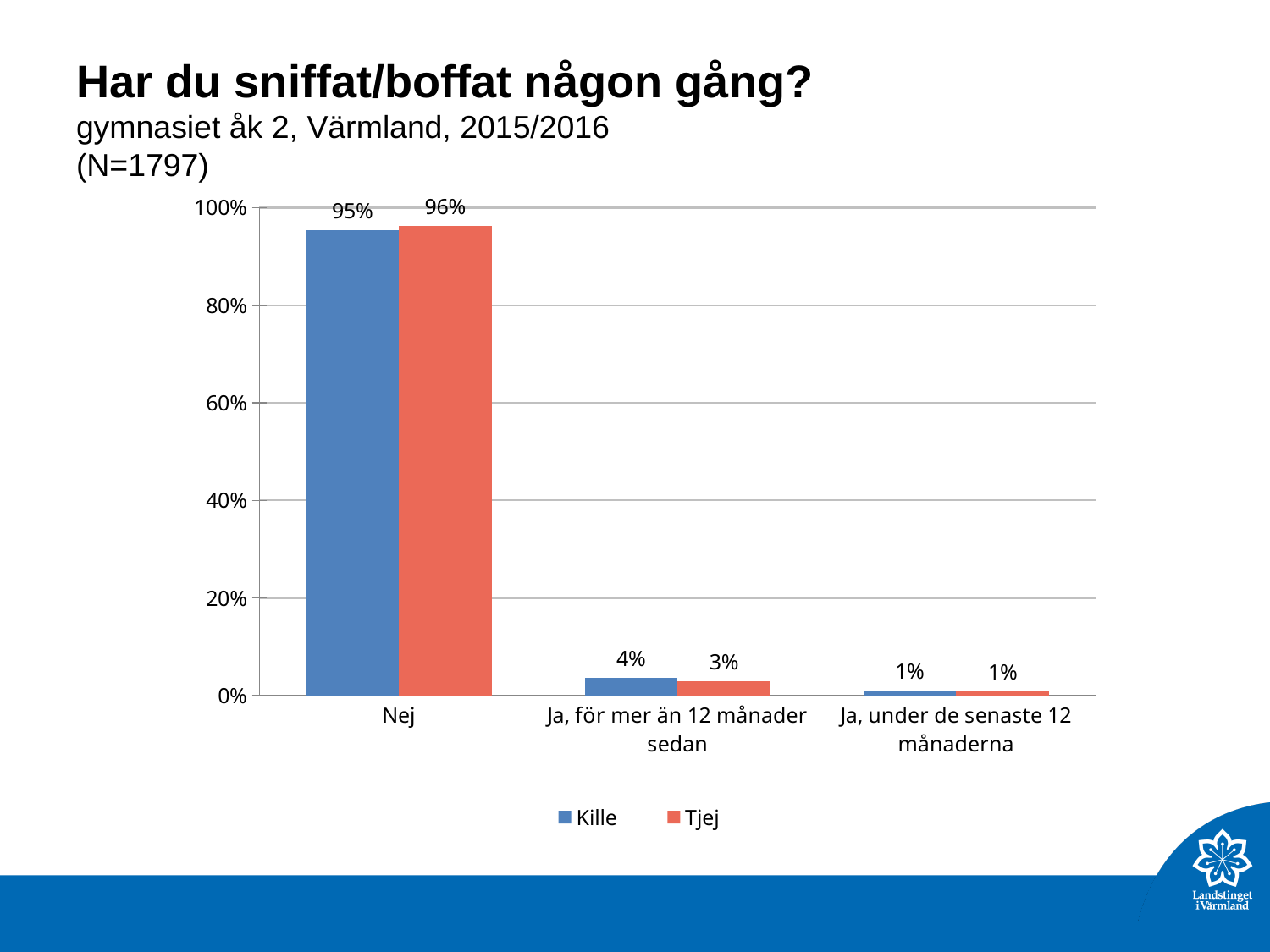
What is the difference between the Tjej and Kille values in the Nej category? 1% How many series does the legend list? 2 In the category 'Ja, för mer än 12 månader sedan', which series has the larger value, Kille or Tjej? Kille What is the value for Kille in the category 'Ja, under de senaste 12 månaderna'? 1% What is the value for Kille in the category 'Ja, för mer än 12 månader sedan'? 4% How many categories are shown on the x axis? 3 What is the value for Kille in the Nej category? 95% Which category has the highest value for Tjej? Nej What kind of chart is shown on the slide? Bar chart What is the value for Tjej in the Nej category? 96% What is the value for Tjej in the category 'Ja, för mer än 12 månader sedan'? 3% Which category has the lowest value for Kille? Ja, under de senaste 12 månaderna